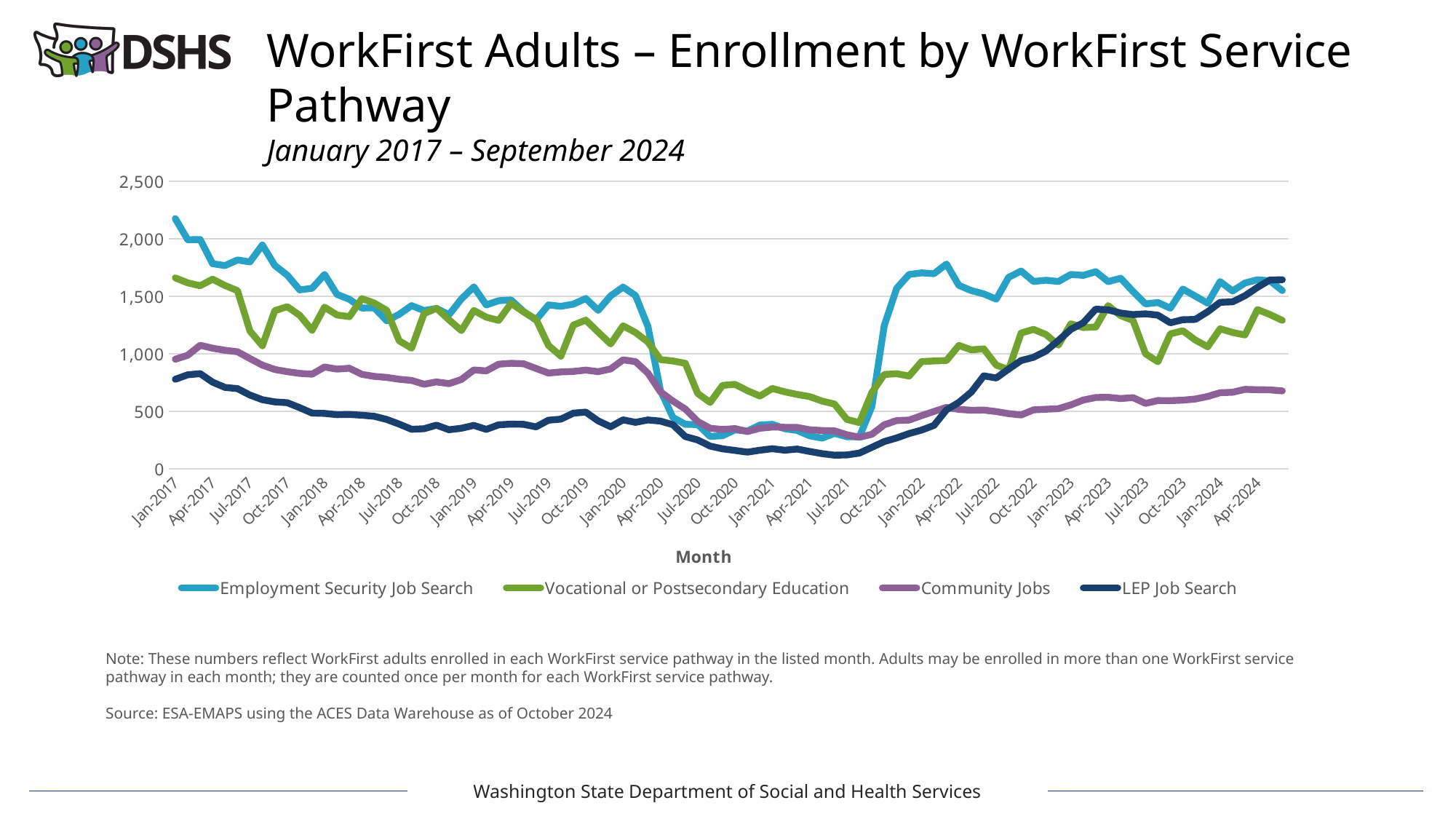
In Jan-2017, which series has the highest enrollment? Employment Security Job Search What are the four series named in the legend? Employment Security Job Search, Vocational or Postsecondary Education, Community Jobs, LEP Job Search Is the value for Employment Security Job Search in Jan-2017 greater or less than 2,000? greater Does the LEP Job Search line rise or fall from Jul-2021 to Apr-2024? rise What kind of chart is shown on the slide? line chart Is the value for Vocational or Postsecondary Education in Jan-2017 greater or less than 1,500? greater Is the value for Community Jobs in Apr-2024 greater or less than 1,000? less In Jan-2017, which series has the lowest enrollment? LEP Job Search What is the title of the x axis? Month In Jan-2022, which is larger: Employment Security Job Search or Community Jobs? Employment Security Job Search How many series does the legend list? 4